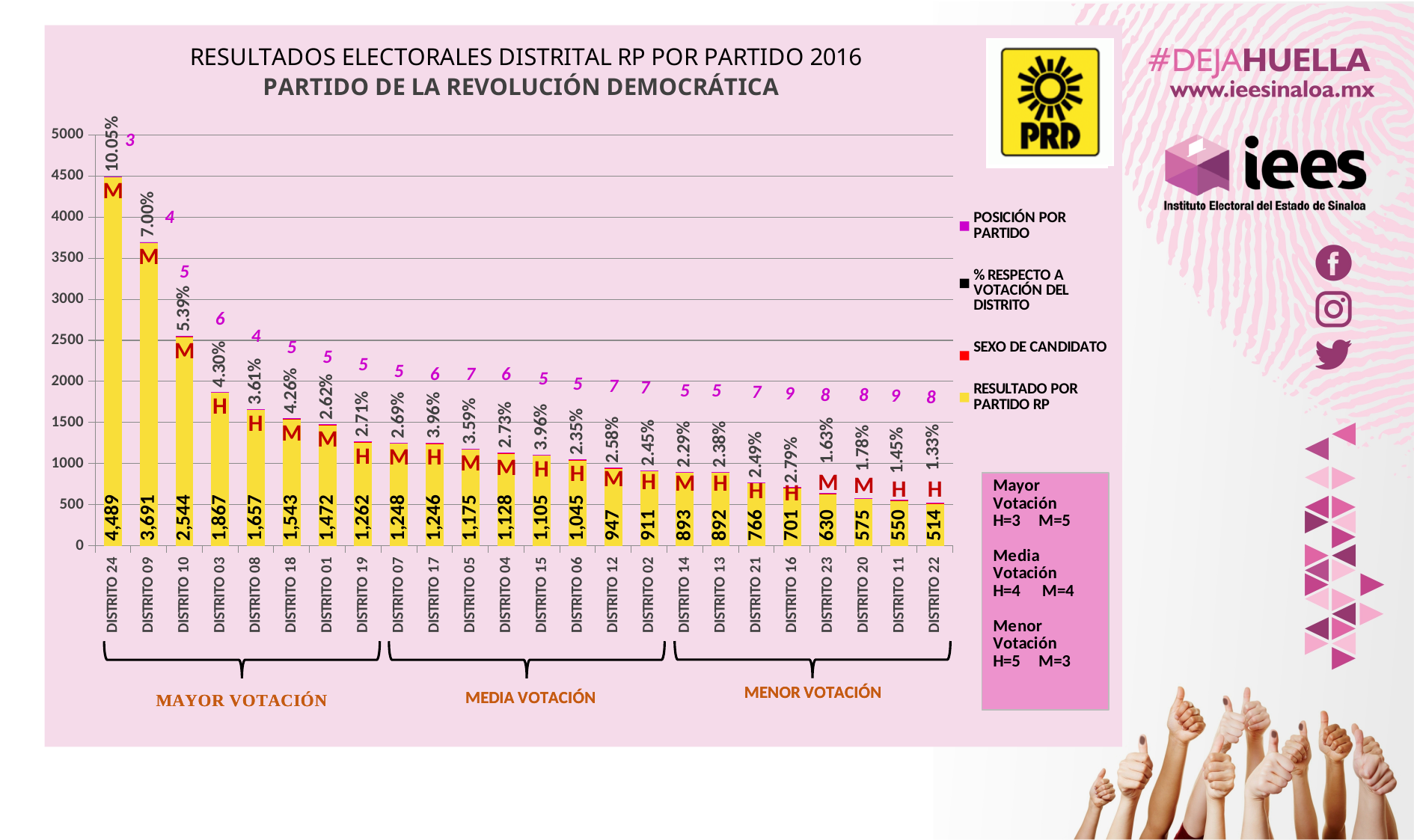
Is the value for DISTRITO 10 greater or less than 2500? greater Which district has the lowest RESULTADO POR PARTIDO RP value? DISTRITO 22 What percentage (% RESPECTO A VOTACIÓN DEL DISTRITO) is shown for DISTRITO 09? 7.00% Which has a larger RESULTADO POR PARTIDO RP value, DISTRITO 03 or DISTRITO 18? DISTRITO 03 What kind of chart is shown on the slide? bar chart Do the RESULTADO POR PARTIDO RP values rise or fall from left to right along the x axis? fall How many districts are shown on the x axis of the chart? 24 Which district has the highest RESULTADO POR PARTIDO RP value? DISTRITO 24 What is the RESULTADO POR PARTIDO RP value for DISTRITO 15? 1,105 How many entries does the chart legend list? 4 What is the difference between the RESULTADO POR PARTIDO RP values of DISTRITO 24 and DISTRITO 09? 798 What is the RESULTADO POR PARTIDO RP value for DISTRITO 24? 4,489